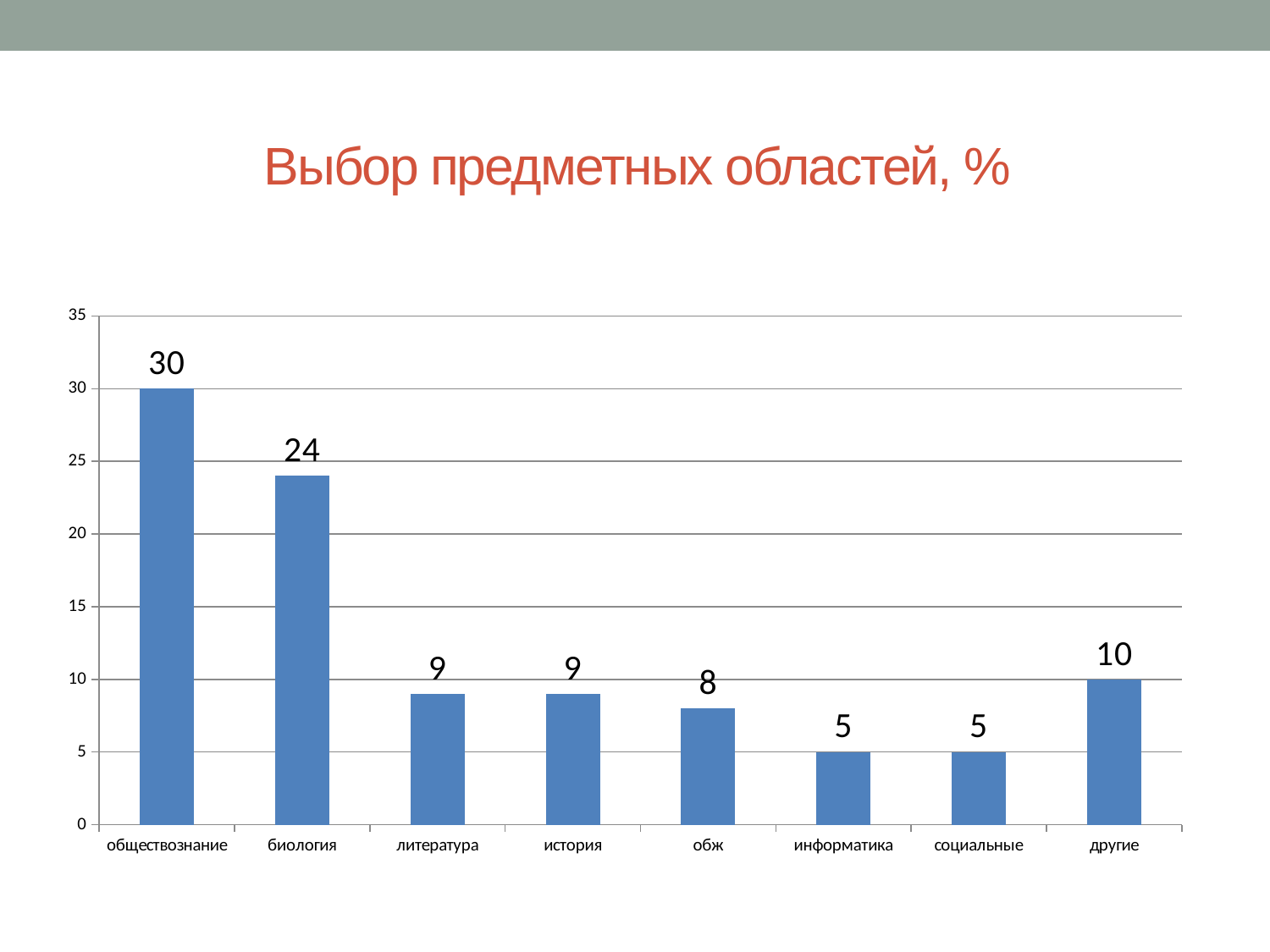
What is the value for обществознание? 30 How many categories are shown on the x axis? 8 What is the value for биология? 24 Which is larger, the value for другие or the value for обж? другие What is the value for обж? 8 Is the value for биология greater or less than 20? greater What is the difference between the values for обществознание and биология? 6 What is the value for другие? 10 What kind of chart is shown on the slide? bar chart What is the difference between the values for литература and информатика? 4 What is the title of the slide? Выбор предметных областей, % Which category has the highest value? обществознание